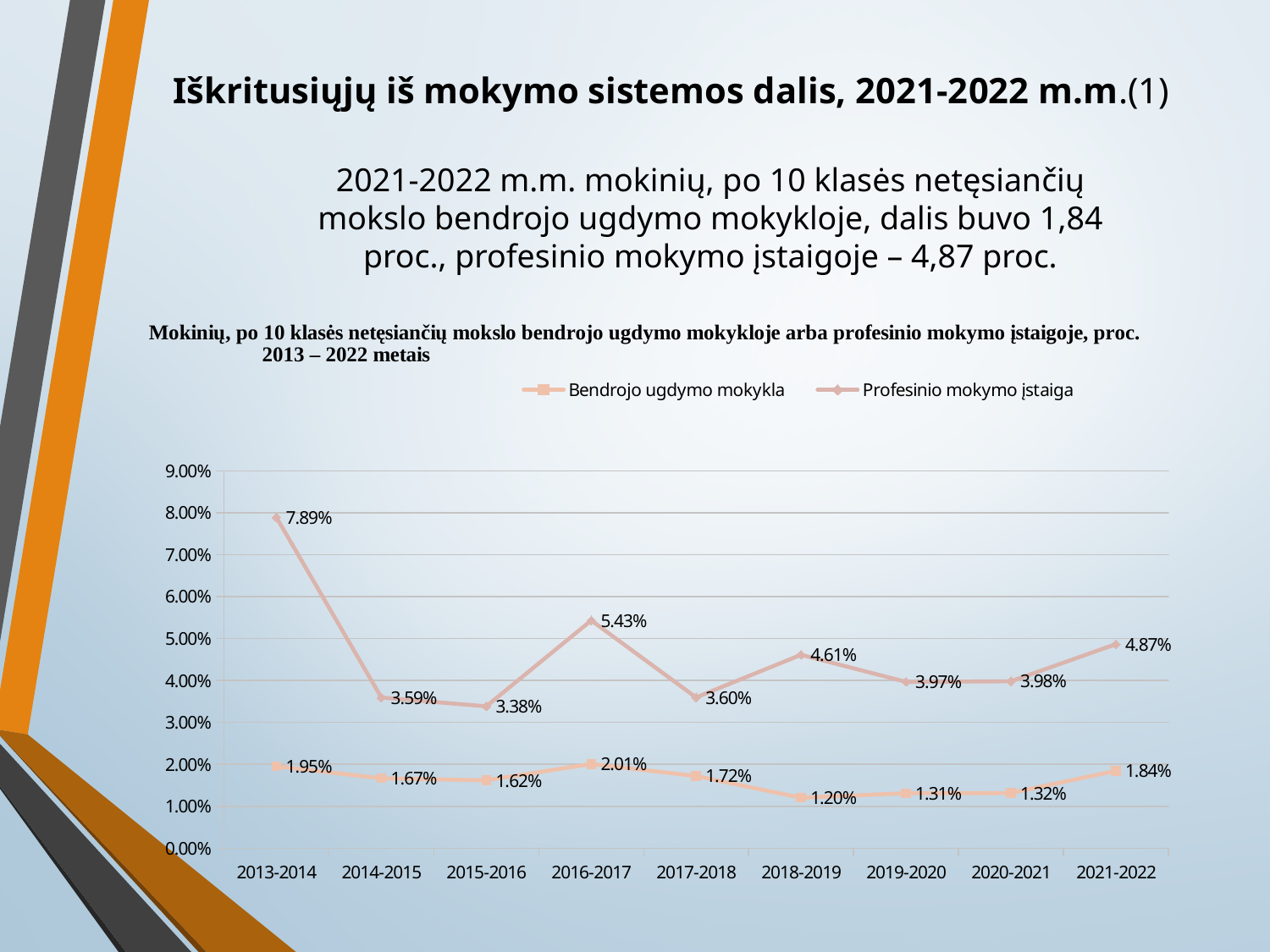
What is the value for Profesinio mokymo įstaiga in 2013-2014? 7.89% In which school year is the Profesinio mokymo įstaiga series highest? 2013-2014 In which school year is the Profesinio mokymo įstaiga series lowest? 2015-2016 What is the value for Bendrojo ugdymo mokykla in 2021-2022? 1.84% How many series does the legend list? 2 What is the value for Bendrojo ugdymo mokykla in 2018-2019? 1.20% Does the Profesinio mokymo įstaiga series rise or fall from 2013-2014 to 2014-2015? Fall Which is larger for Profesinio mokymo įstaiga: the value in 2016-2017 or in 2018-2019? 2016-2017 What is the difference between the Profesinio mokymo įstaiga and Bendrojo ugdymo mokykla values in 2021-2022? 3.03% How many school years are shown on the x axis? 9 In which school year is the Bendrojo ugdymo mokykla series lowest? 2018-2019 What kind of chart is shown on the slide? Line chart